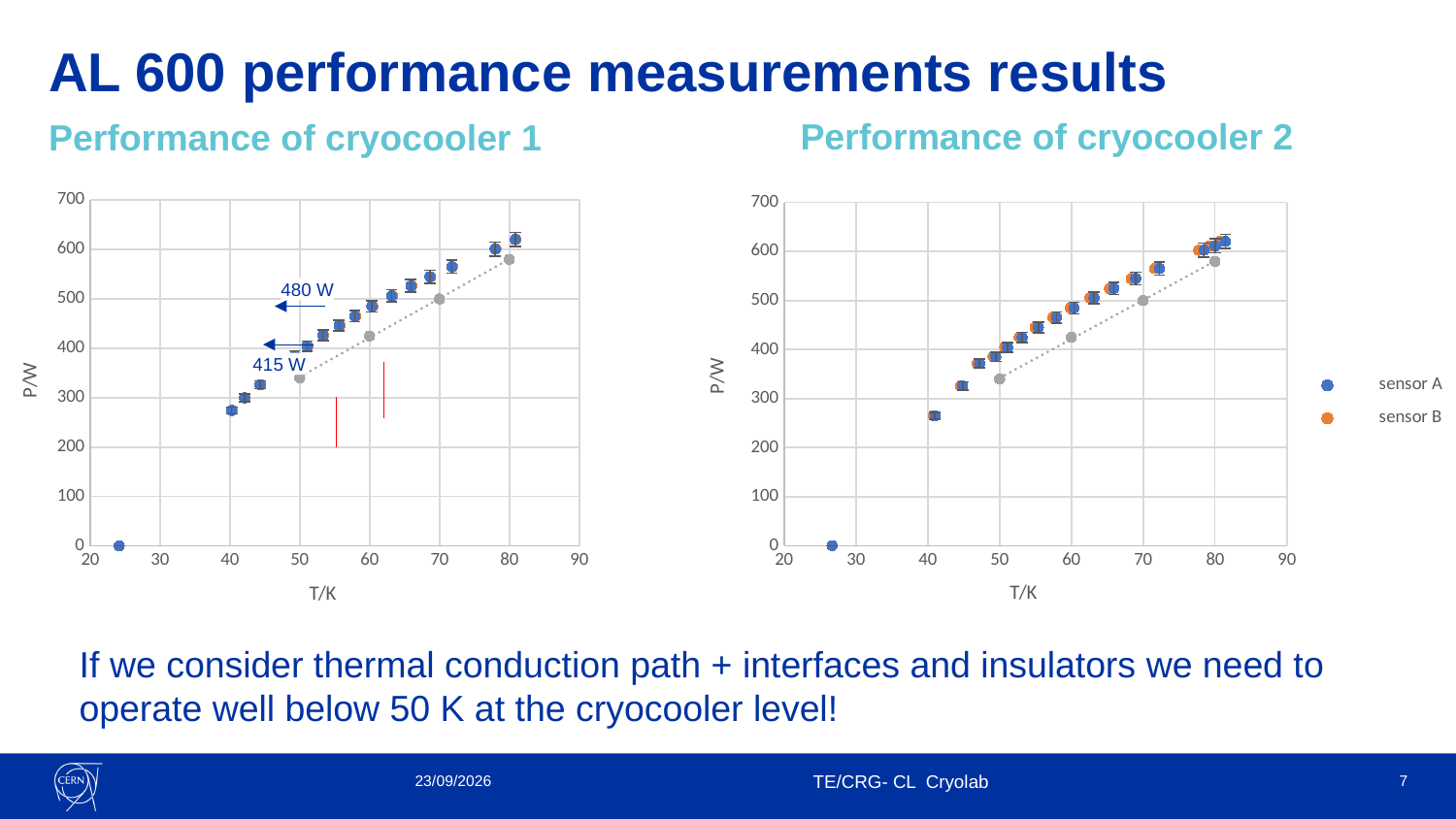
In "Performance of cryocooler 1", is the blue point at about 40 K greater or less than 300? less What two power values are annotated with arrows in "Performance of cryocooler 1"? 480 W and 415 W In "Performance of cryocooler 2", is the highest plotted value greater or less than 600? greater What are the legend entries in "Performance of cryocooler 2"? sensor A, sensor B In "Performance of cryocooler 1", what is the label of the y axis? P/W In "Performance of cryocooler 1", is the highest plotted blue point greater or less than 600? greater What is the maximum value shown on the y axis of "Performance of cryocooler 1"? 700 How many series does the legend of "Performance of cryocooler 2" list? 2 What kind of chart is "Performance of cryocooler 1"? Scatter chart In "Performance of cryocooler 2", do the plotted P/W values rise or fall as T/K increases? Rise